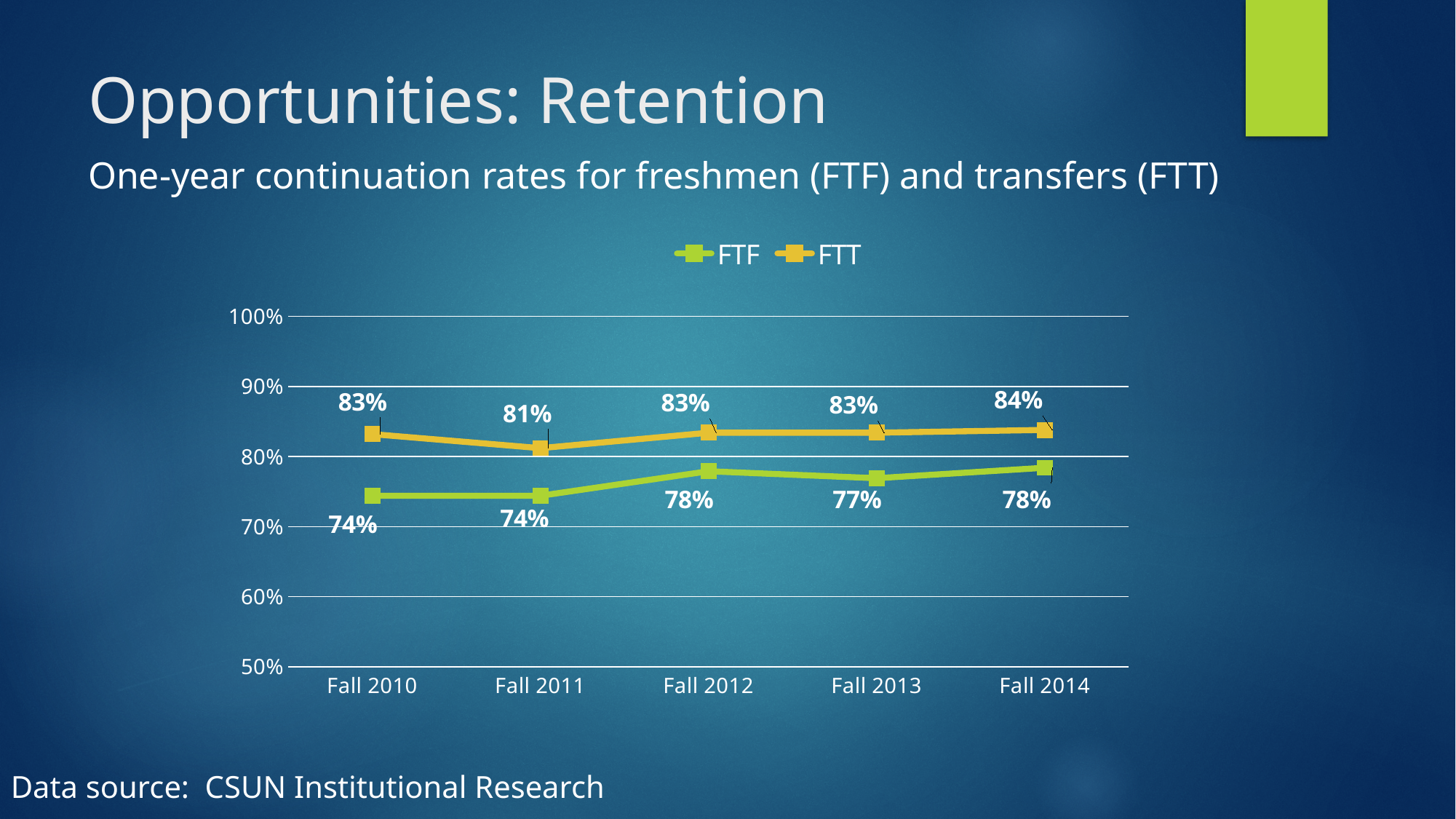
What kind of chart is shown on the slide? line chart What is the difference between the FTT and FTF rates in Fall 2010? 9% Which is larger in Fall 2013, the FTF rate or the FTT rate? FTT What is the FTF value for Fall 2010? 74% Does the FTF rate rise or fall from Fall 2011 to Fall 2012? rise Is the FTF value for Fall 2014 greater or less than 80%? less How many terms are shown on the x axis? 5 In which term is the FTT rate lowest? Fall 2011 What is the FTT one-year continuation rate for Fall 2011? 81% What is the FTF one-year continuation rate for Fall 2012? 78% How many series does the legend list? 2 In which term is the FTT rate highest? Fall 2014